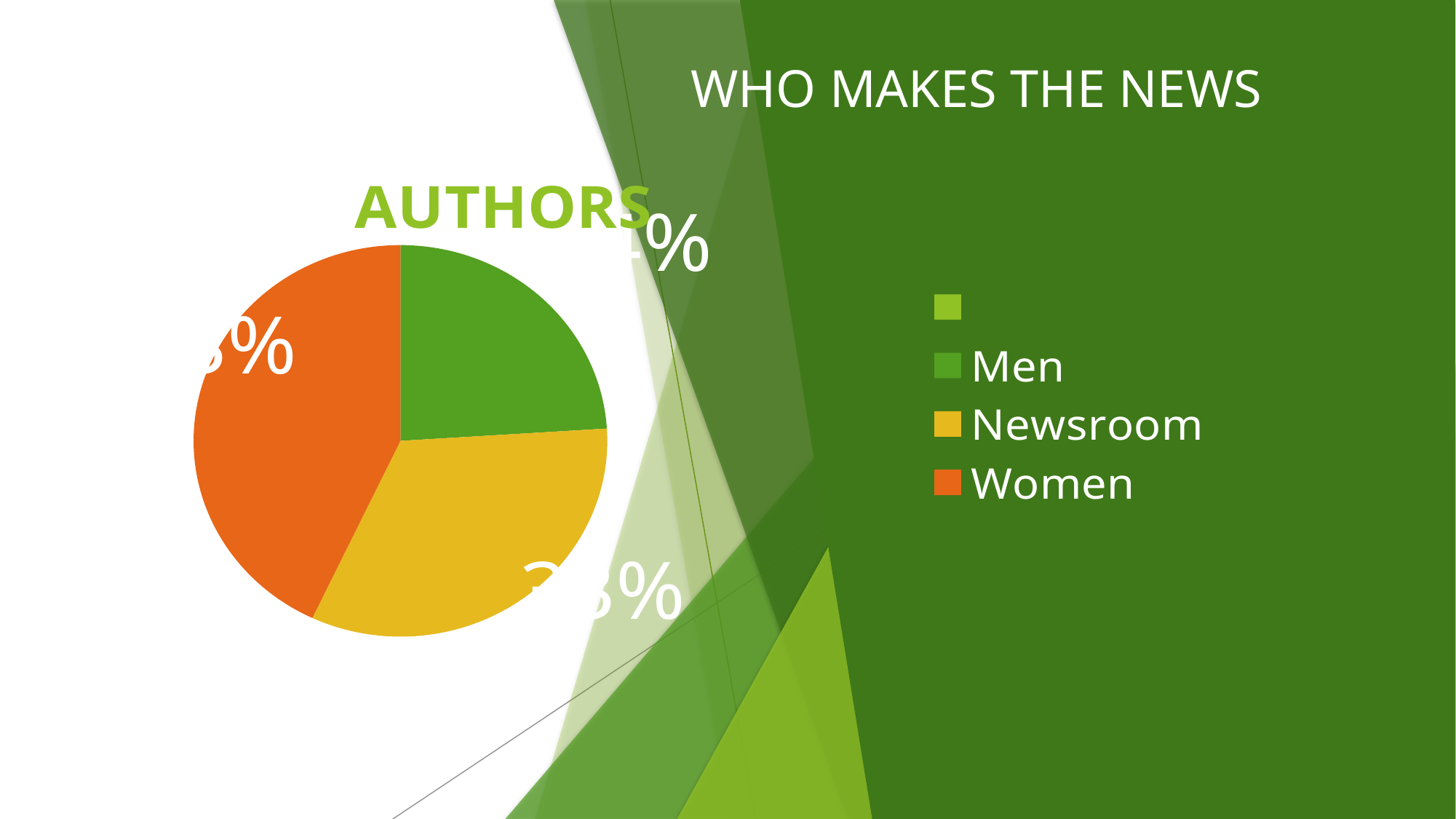
Which slice is larger, Newsroom or Men? Newsroom Which slice is larger, Women or Newsroom? Women What kind of chart is shown on the slide? pie chart Which category has the largest slice of the pie chart? Women Which category has the smallest slice of the pie chart? Men How many slices does the pie chart have? 3 What colour is the Newsroom slice in the pie chart? yellow What is the title of the pie chart? AUTHORS Which slice is larger, Men or Women? Women